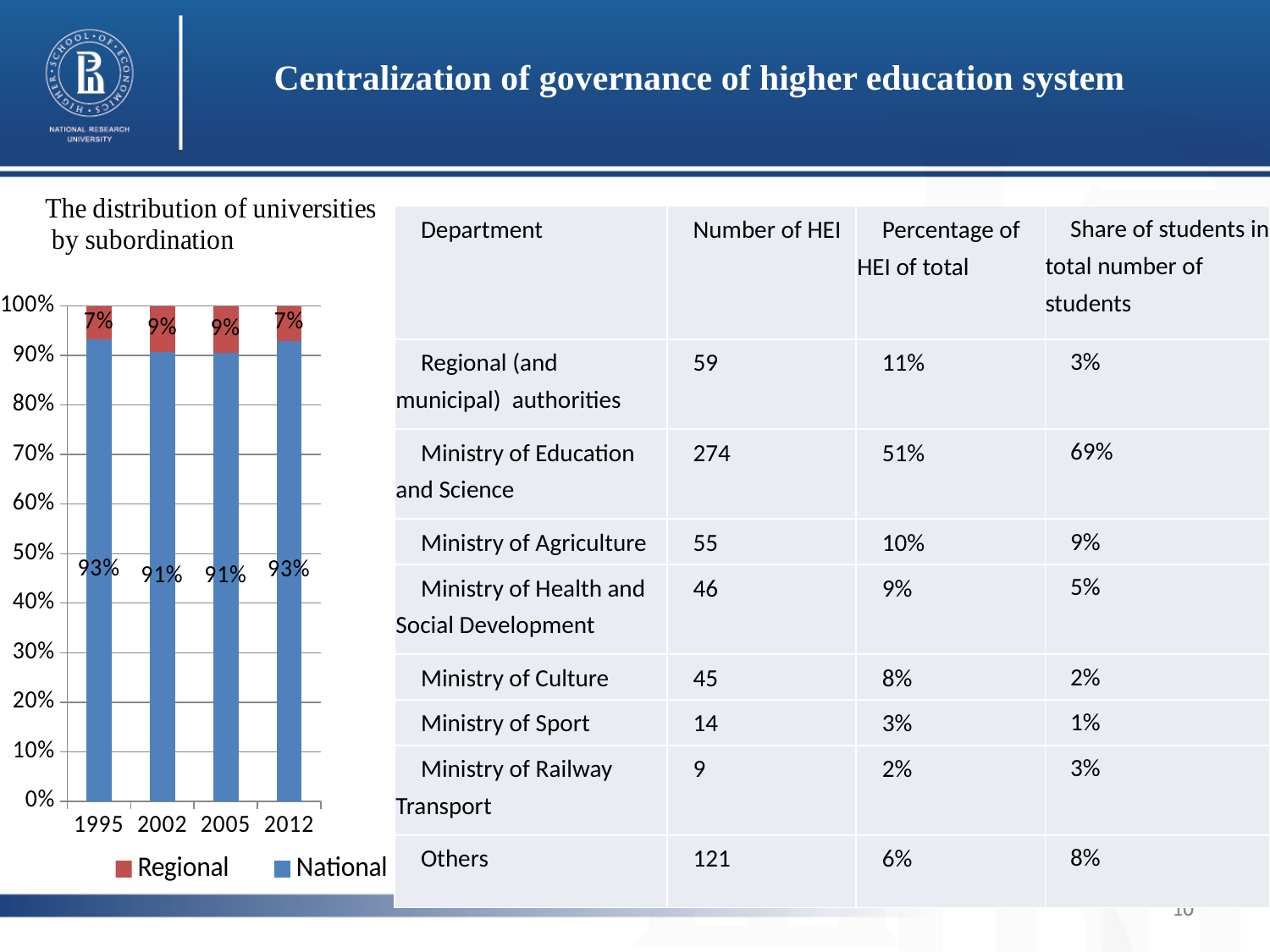
What is the difference between the National and Regional values in 2002? 82% How many series does the chart legend list? 2 What is the National value for 1995? 93% What is the Regional value for 2012? 7% Is the National value for 2012 larger or smaller than the National value for 2005? larger What is the Regional value for 2002? 9% How many years are shown on the x axis of the chart? 4 What is the National value for 2005? 91% What is the total of the stacked bar for 2005? 100% What kind of chart is shown on the slide? stacked bar chart Which year has the lowest National share? 2002 and 2005 (91%) Is the Regional value for 1995 greater or less than 10%? less